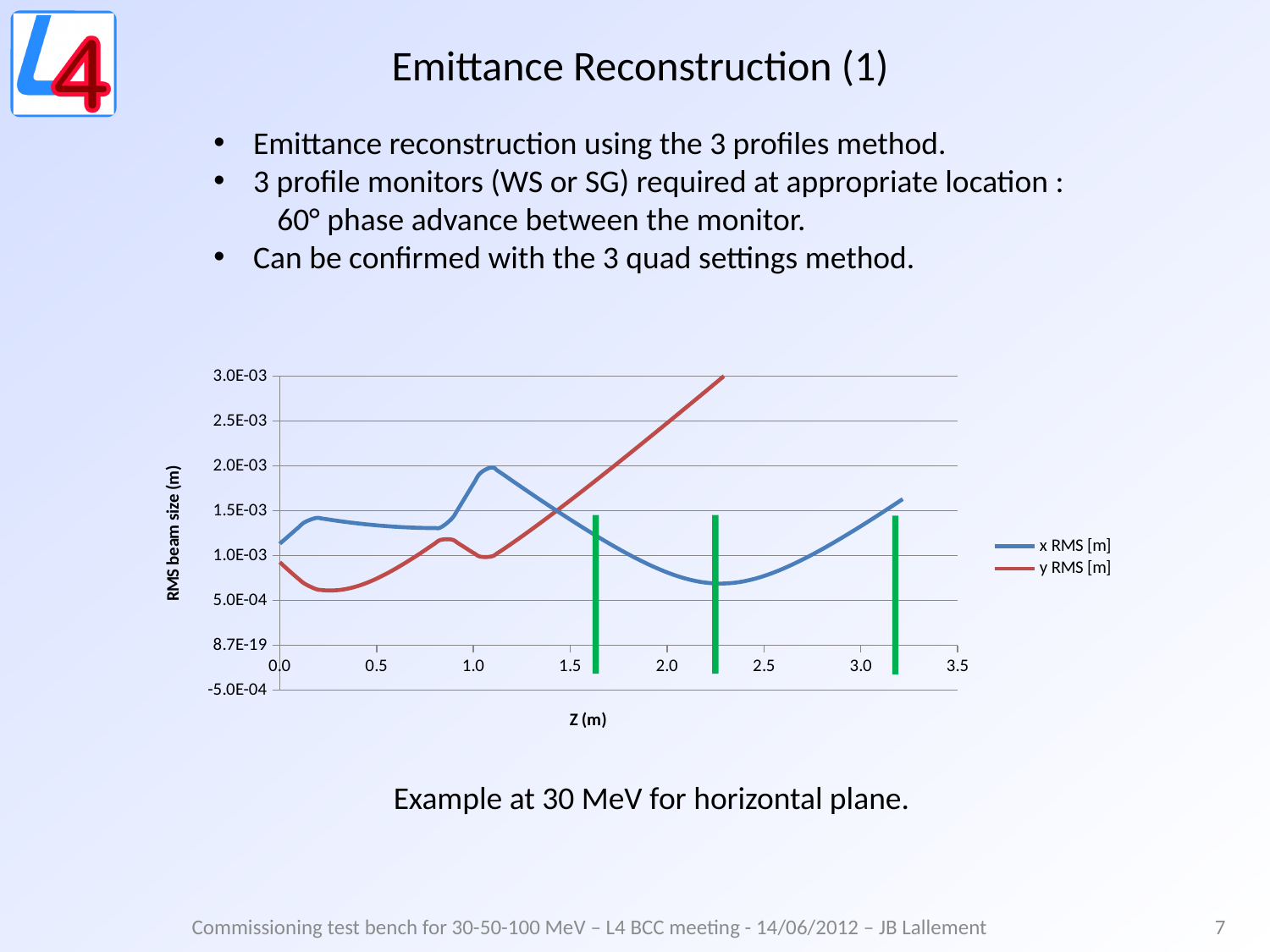
Does the x RMS [m] series rise or fall between Z = 1.5 and Z = 2.0? fall Is the value of y RMS [m] at Z = 2.0 greater or less than 1.5E-03? greater Is the value of x RMS [m] at Z = 1.0 greater or less than 1.5E-03? greater Does the y RMS [m] series rise or fall between Z = 1.0 and Z = 2.0? rise At Z = 2.0, which series has the larger value, x RMS [m] or y RMS [m]? y RMS [m] What is the title of the horizontal axis? Z (m) Is the value of y RMS [m] at Z = 0.5 greater or less than 1.0E-03? less How many series does the legend list? 2 What are the two series named in the legend? x RMS [m] and y RMS [m] What kind of chart is shown on the slide? line chart At Z = 0.5, which series has the larger value, x RMS [m] or y RMS [m]? x RMS [m]